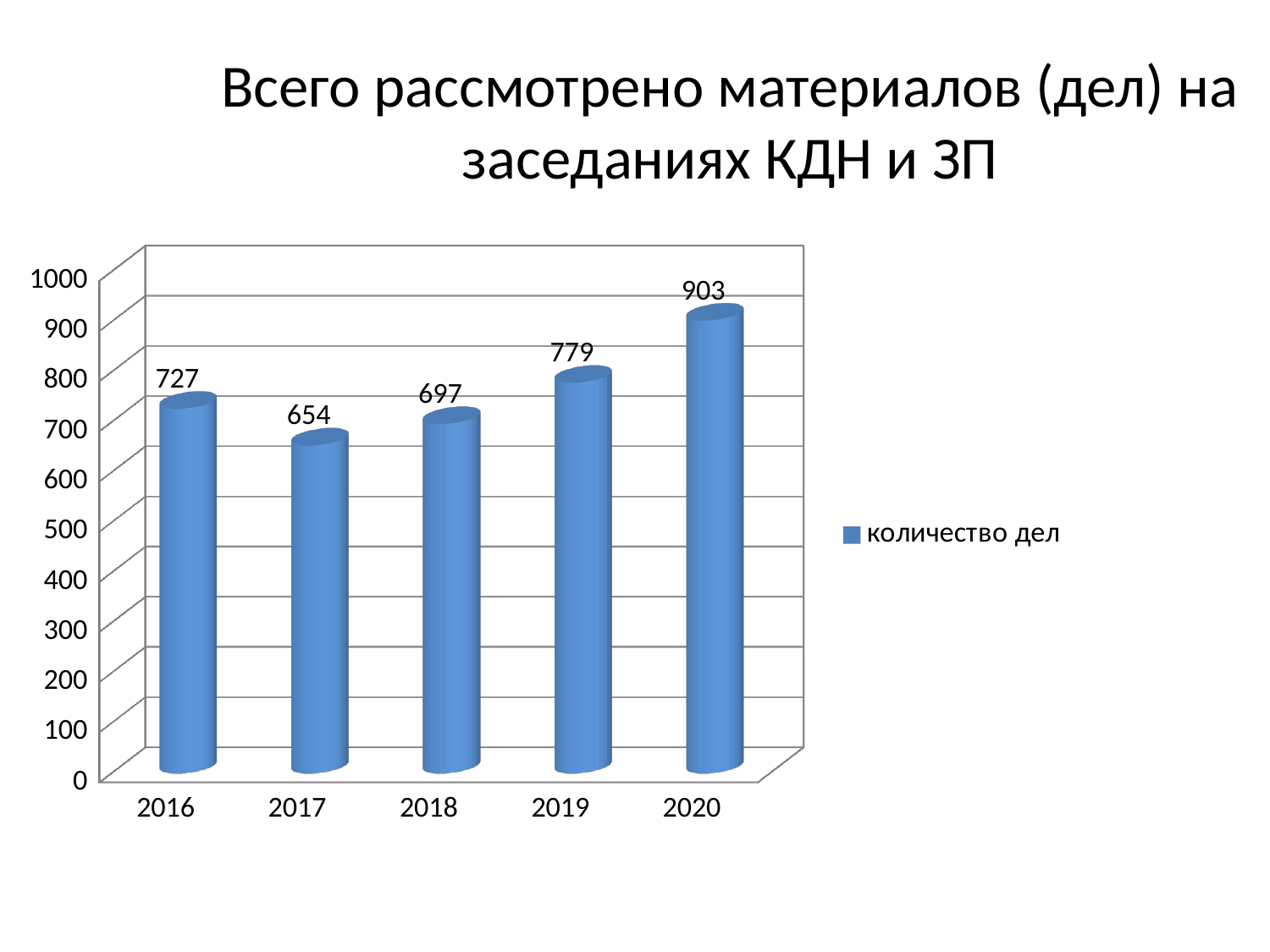
What is the series name shown in the legend? количество дел Which year has the lowest value? 2017 Is the value for 2019 greater or less than 700? greater Which year has the highest value? 2020 What is the difference between the values for 2020 and 2019? 124 What is the difference between the values for 2016 and 2017? 73 What is the value for 2016? 727 What is the value for 2018? 697 What is the value for 2020? 903 What kind of chart is shown on the slide? bar chart How many years are shown on the x axis? 5 Which is larger, the value for 2016 or the value for 2018? 2016